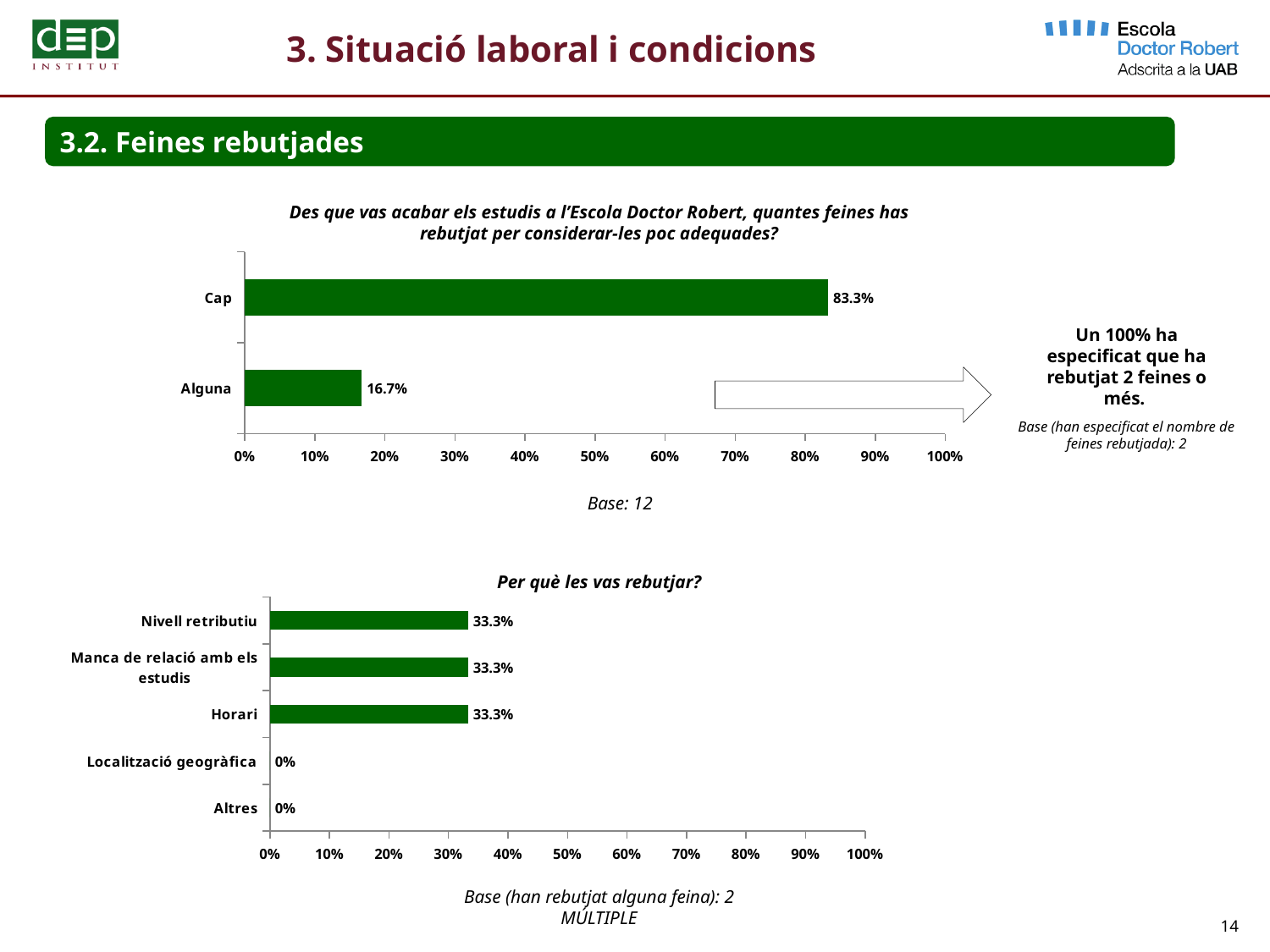
In the top chart, what is the value for "Alguna"? 16.7% In the top chart ("Des que vas acabar els estudis..."), what is the value for "Cap"? 83.3% In the bottom chart, what is the value for "Localització geogràfica"? 0% In the bottom chart, how many categories are shown? 5 What kind of chart is the bottom chart? Bar chart In the top chart, is the value for "Cap" greater or less than 80%? greater In the top chart, how many categories are shown? 2 What is the base (number of respondents) stated below the top chart? 12 In the top chart, what is the difference between the values for "Cap" and "Alguna"? 66.6% In the bottom chart ("Per què les vas rebutjar?"), what is the value for "Horari"? 33.3% In the bottom chart, which of the two is larger: "Nivell retributiu" or "Altres"? Nivell retributiu In the top chart, which category has the highest value? Cap